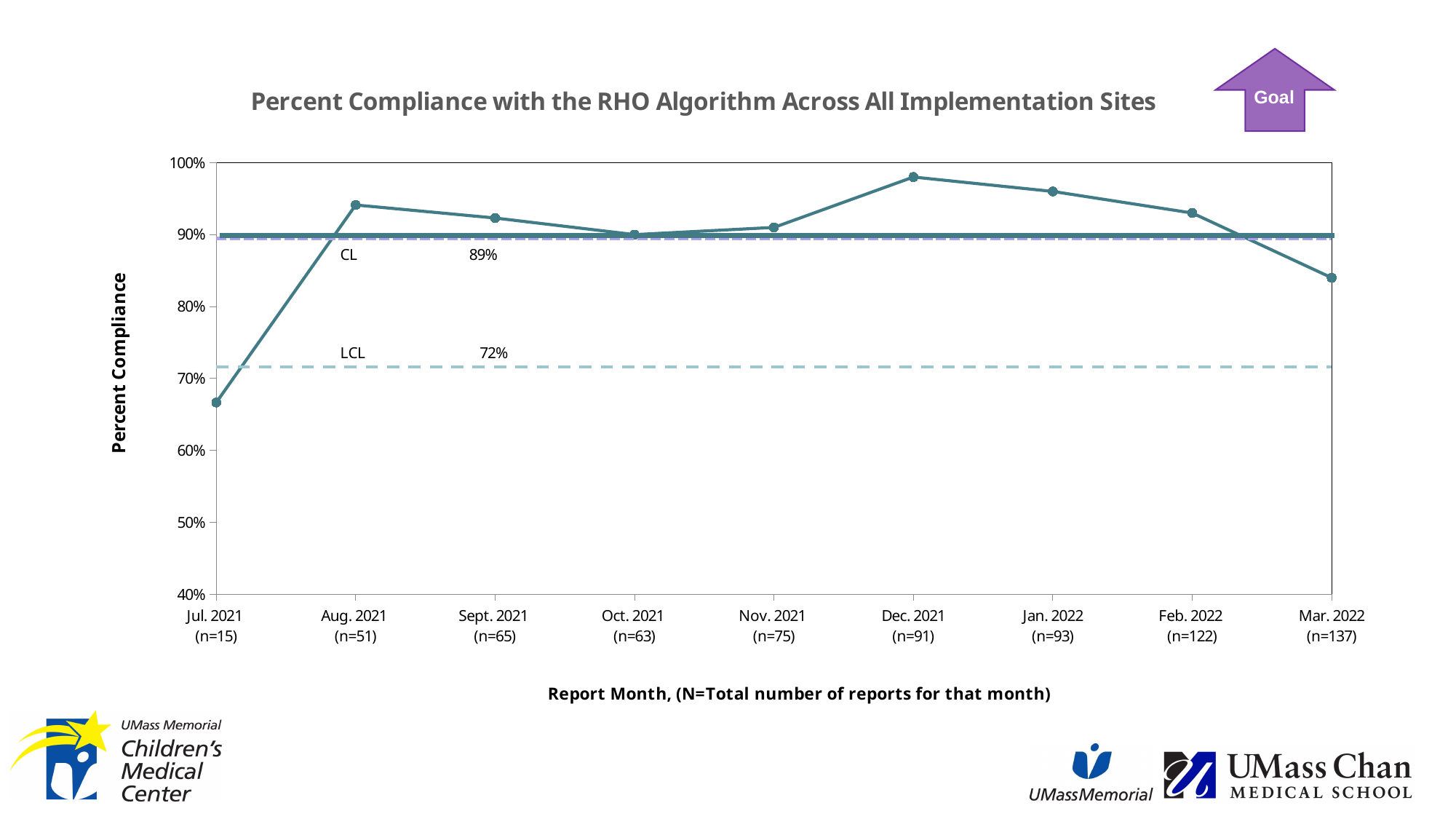
Which has the higher percent compliance, Aug. 2021 or Mar. 2022? Aug. 2021 Is the value for Jul. 2021 greater or less than 70%? less What value is labelled for the LCL on the chart? 72% Is the value for Mar. 2022 greater or less than 90%? less What value is labelled for the CL (center line) on the chart? 89% Do the values rise or fall from Dec. 2021 to Mar. 2022? fall What is the title of the chart? Percent Compliance with the RHO Algorithm Across All Implementation Sites Which report month has the highest percent compliance? Dec. 2021 Which report month has the lowest percent compliance? Jul. 2021 Is the value for Dec. 2021 greater or less than 90%? greater How many report months are plotted on the x axis? 9 What kind of chart is shown on the slide? line chart